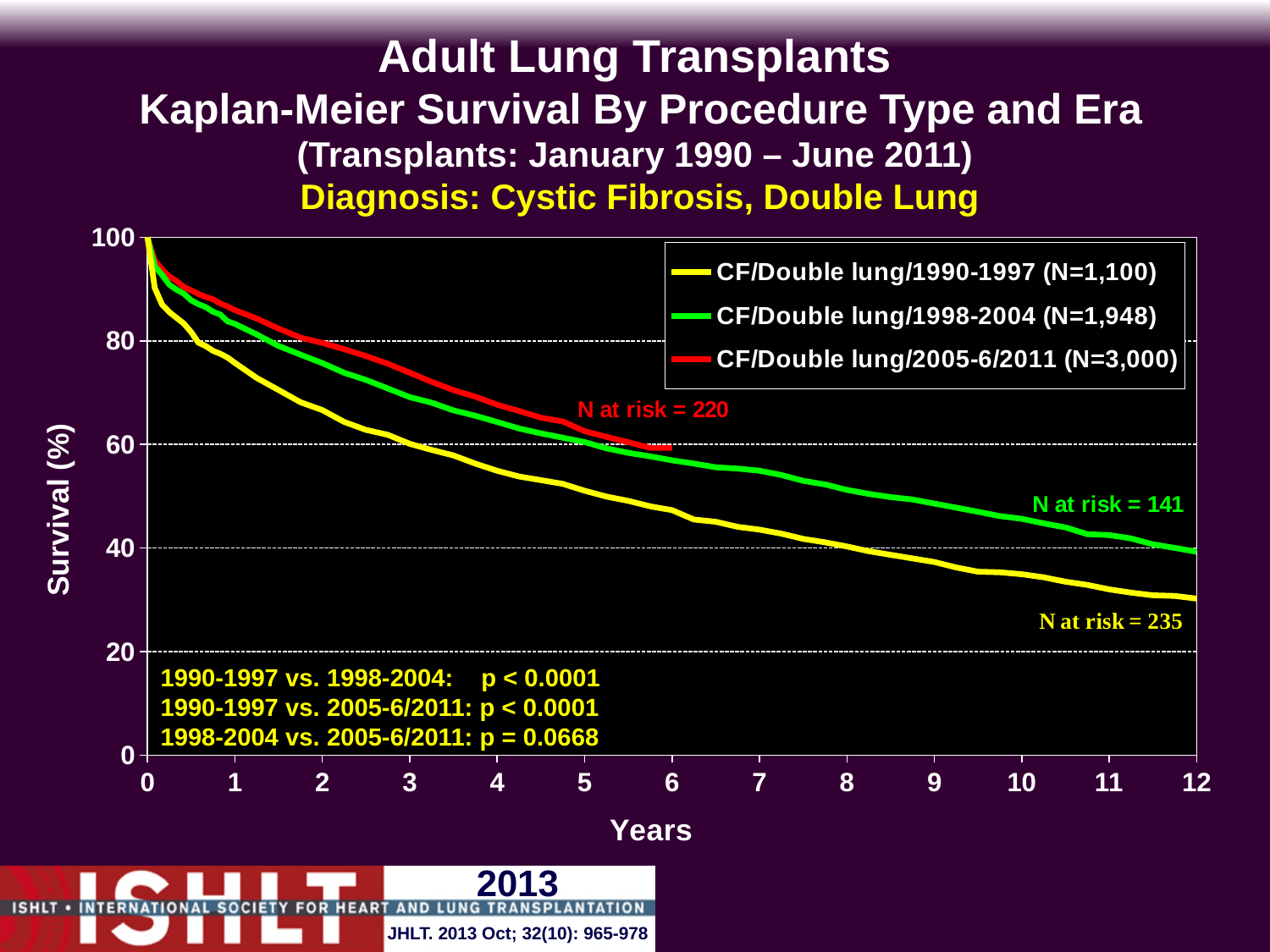
What is the N at risk printed for the CF/Double lung/2005-6/2011 curve? 220 How many series does the legend list? 3 According to the legend, how many transplants (N) are in the CF/Double lung/1998-2004 group? 1,948 Which era has the lowest survival at 12 years? CF/Double lung/1990-1997 Is the survival for CF/Double lung/2005-6/2011 at 1 year greater or less than 80? greater Which era has the highest survival at 3 years? CF/Double lung/2005-6/2011 Do the survival curves rise or fall as years increase? fall What kind of chart is shown on the slide? line chart What p-value is shown for 1998-2004 vs. 2005-6/2011? p = 0.0668 Is the survival for CF/Double lung/1990-1997 at 12 years greater or less than 40? less What is the N at risk printed for the CF/Double lung/1998-2004 curve? 141 What is the N at risk printed for the CF/Double lung/1990-1997 curve? 235